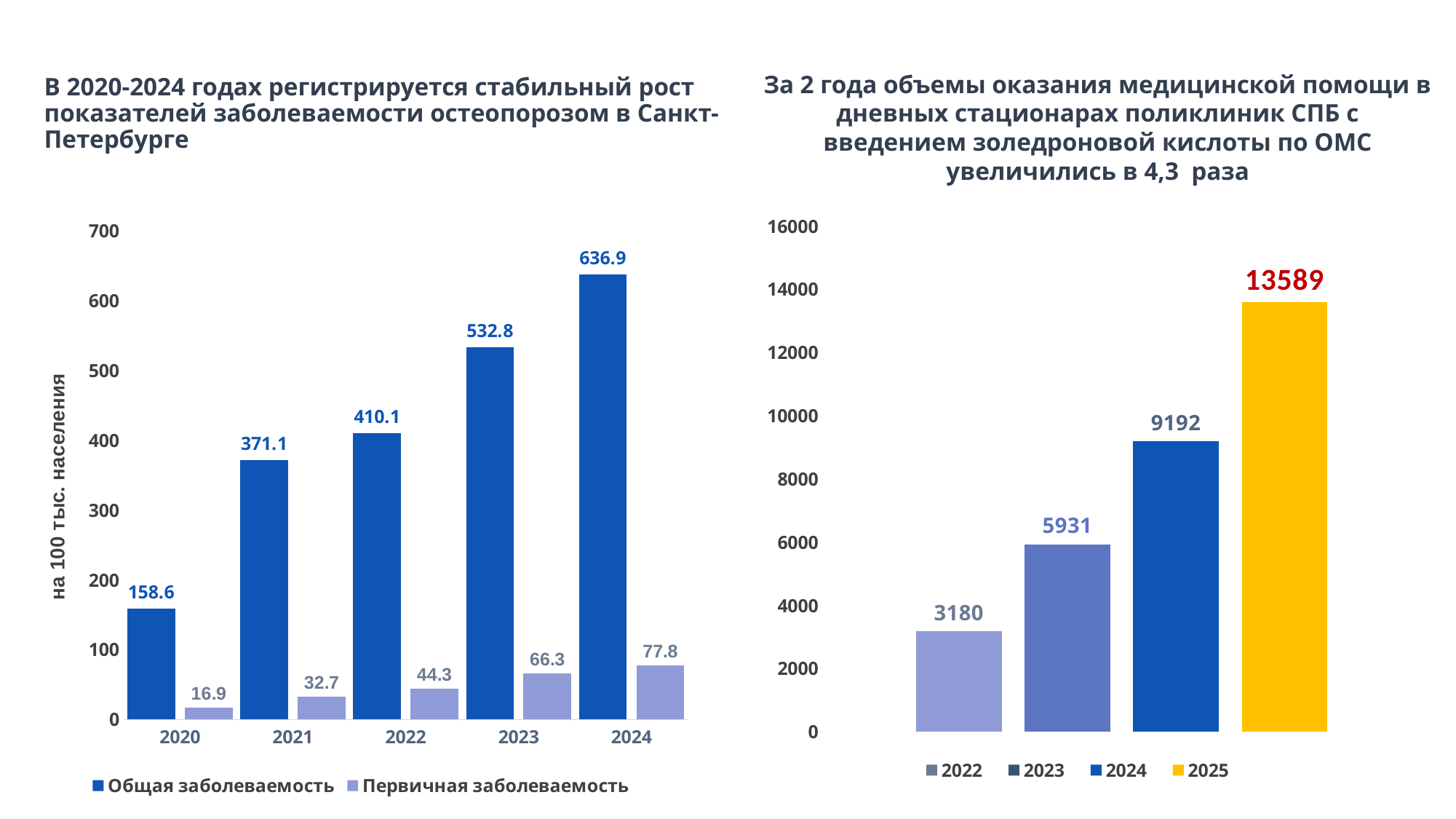
In the left chart, what is the y-axis label? на 100 тыс. населения In the left chart, what is the value of Первичная заболеваемость for 2021? 32.7 In the left chart, what is the value of Общая заболеваемость for 2024? 636.9 In the right chart, what is the difference between the values for 2024 and 2023? 3261 In the right chart, what is the value for 2025? 13589 In the left chart, which year has the lowest value of Общая заболеваемость? 2020 What type of chart is the right chart? bar chart In the left chart, do the values of Первичная заболеваемость rise or fall from 2020 to 2024? rise In the right chart, how many bars are plotted? 4 In the left chart, what is the difference between Общая заболеваемость in 2024 and in 2023? 104.1 In the right chart, what is the value for 2022? 3180 In the left chart, how many series does the legend list? 2